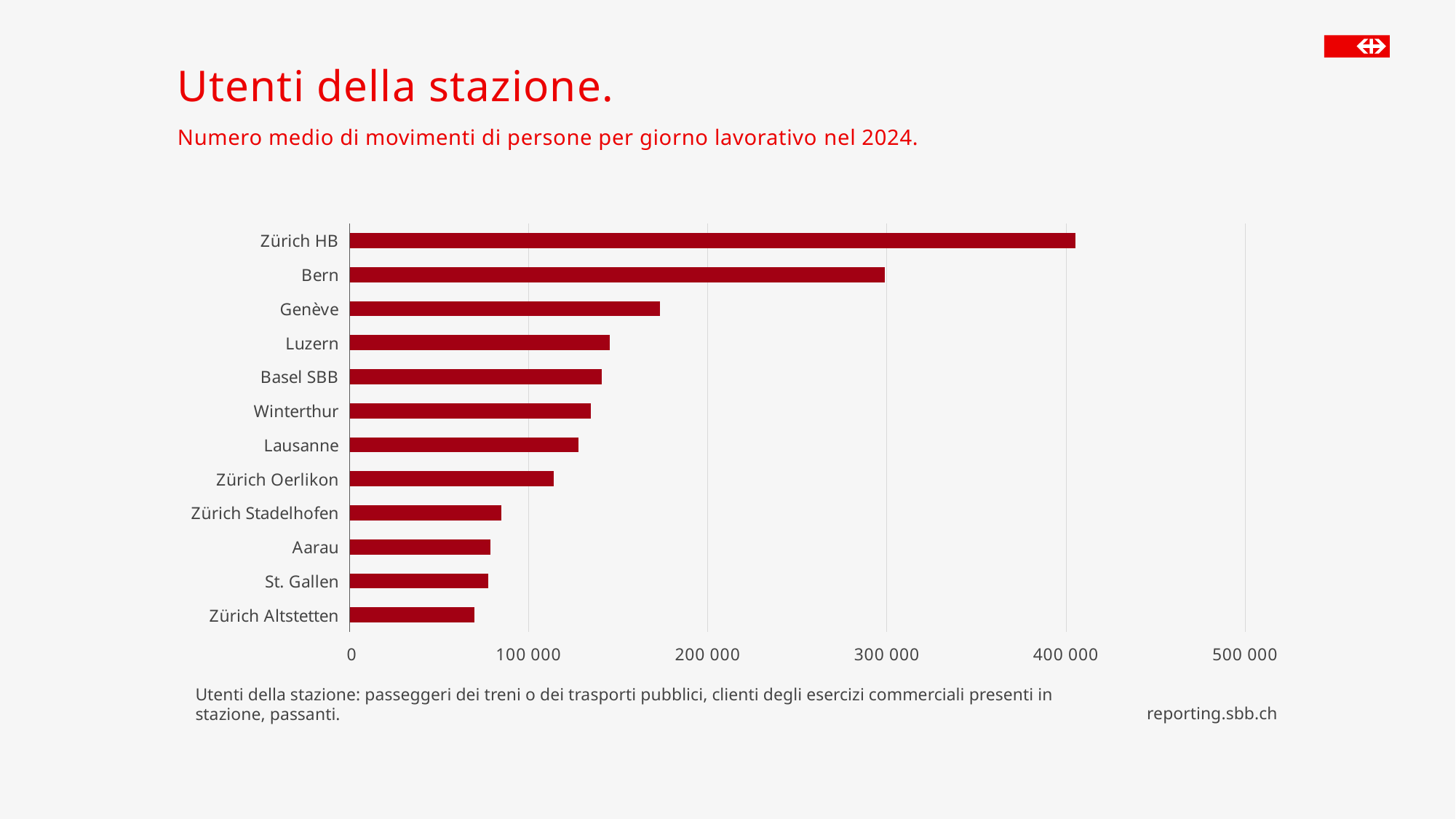
Is the value for Zürich HB greater or less than 300 000? greater Which station has the lowest number of average daily person movements? Zürich Altstetten Which station has the highest number of average daily person movements? Zürich HB Is the value for Genève greater or less than 200 000? less Which has a higher value, Lausanne or Zürich Oerlikon? Lausanne Which has a higher value, Genève or Luzern? Genève What is the title of the chart on the slide? Utenti della stazione. Is the value for Zürich Altstetten greater or less than 100 000? less What kind of chart is shown on the slide? Bar chart How many stations are shown in the chart? 12